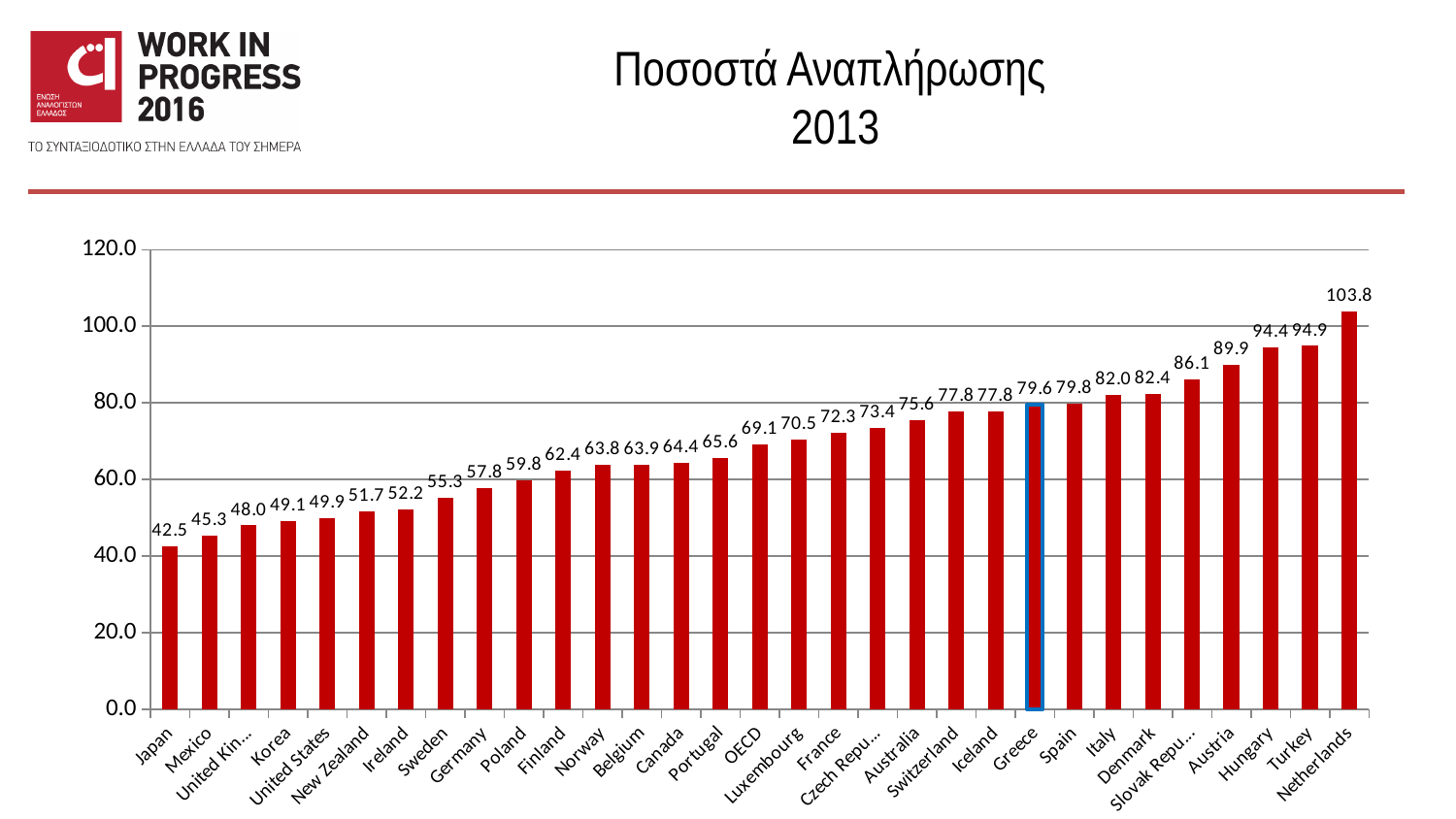
Which bar is outlined in blue? Greece What is the value for Japan? 42.5 What is the value for the OECD? 69.1 What is the value for Netherlands? 103.8 What is the difference between the values for Greece and the OECD? 10.5 Which is larger, the value for Austria or the value for Italy? Austria What is the value for Greece? 79.6 How many categories are shown on the x axis? 31 What is the difference between the values for Netherlands and Japan? 61.3 Which category has the highest value? Netherlands Which category has the lowest value? Japan What kind of chart is shown on the slide? Bar chart